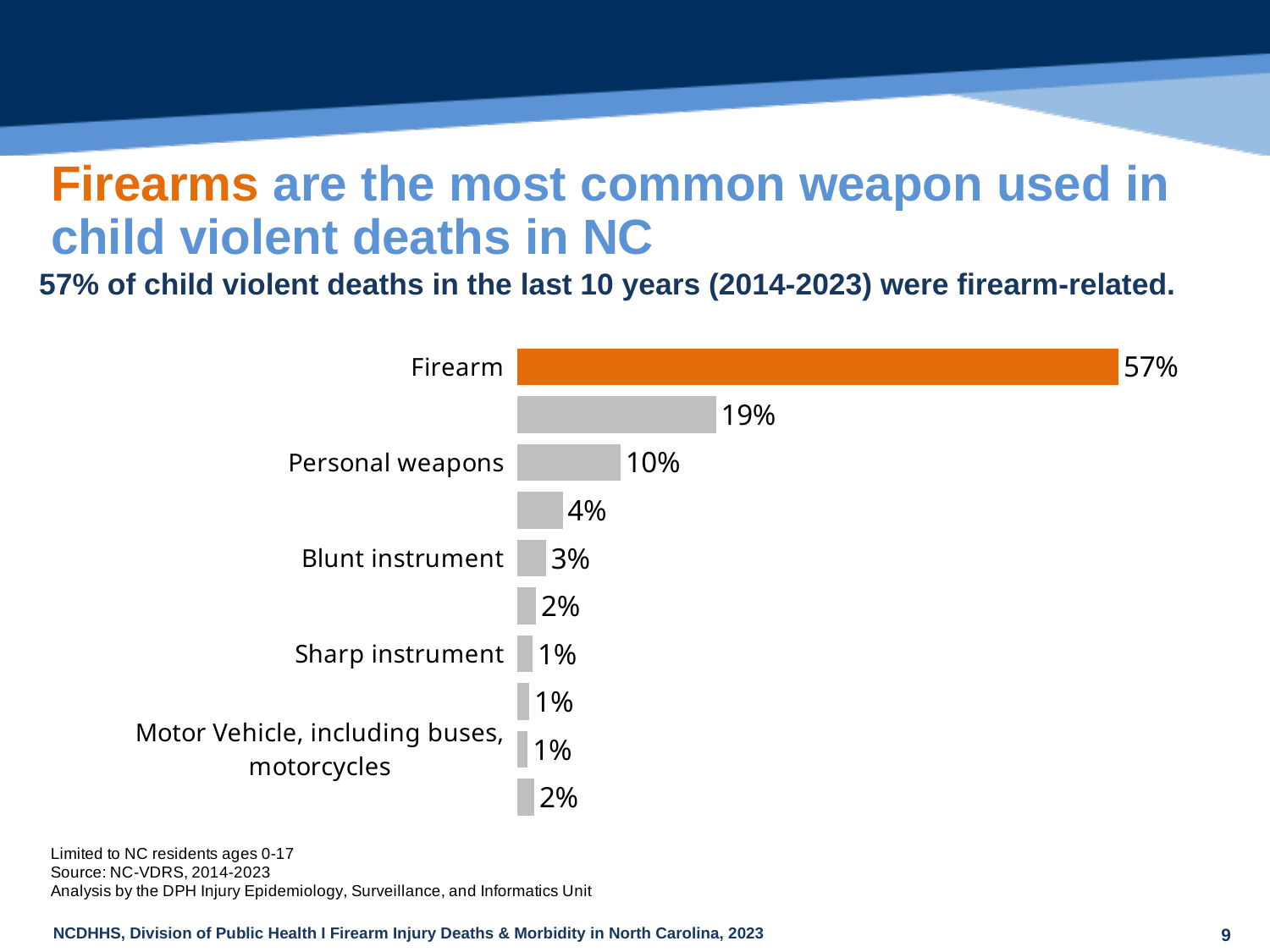
What value is shown for Blunt instrument? 3% What is the difference between the Blunt instrument and Sharp instrument percentages? 2% Which weapon category has the highest percentage? Firearm What colour is the Firearm bar? Orange What is the difference between the Firearm and Personal weapons percentages? 47% What value is shown for Motor Vehicle, including buses, motorcycles? 1% What value is shown for Sharp instrument? 1% What value is shown for Personal weapons? 10% Which is larger, the value for Personal weapons or the value for Blunt instrument? Personal weapons What type of chart is shown on the slide? Bar chart How many bars are plotted in the chart? 10 What percentage of child violent deaths is shown for Firearm? 57%